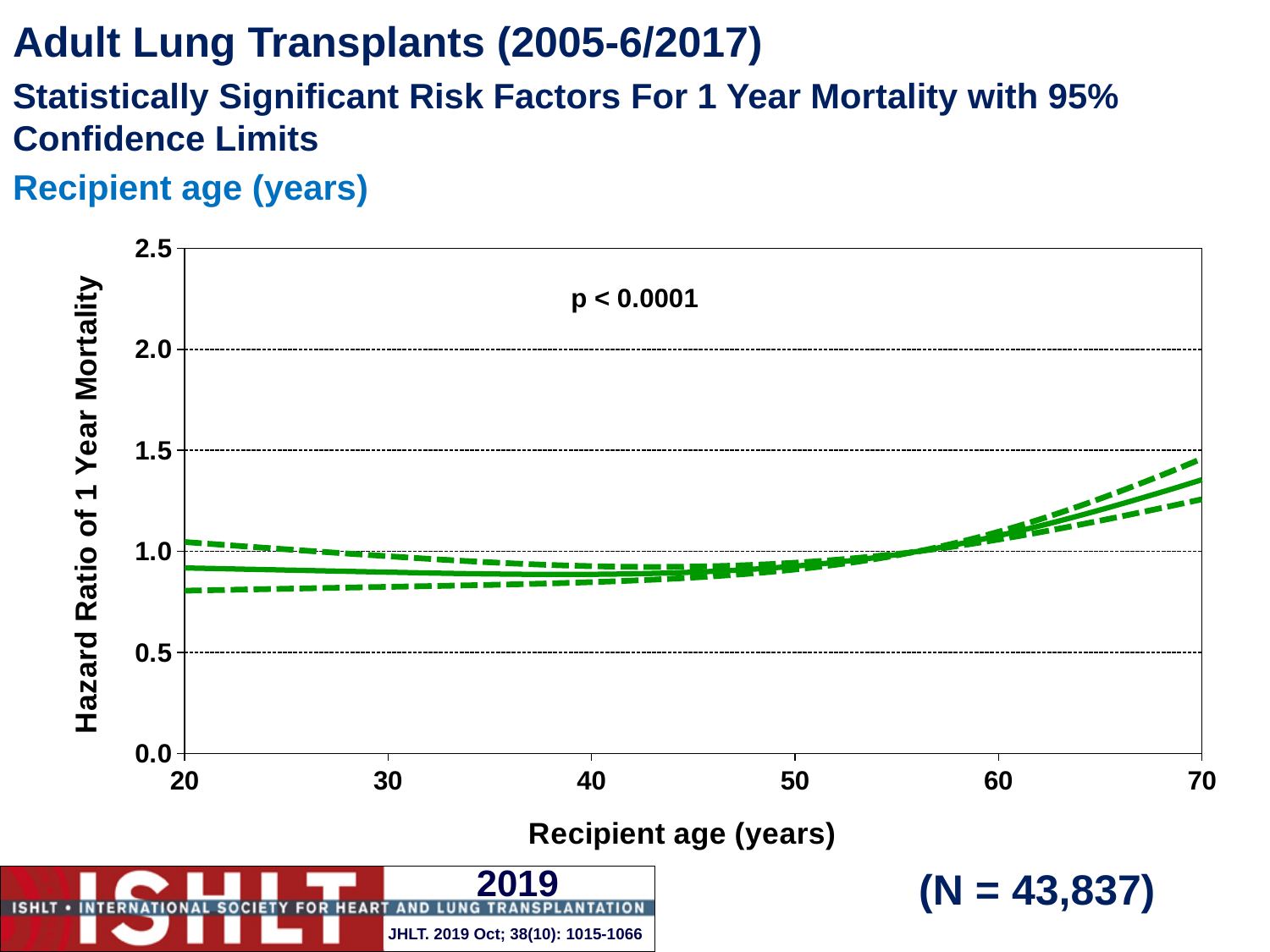
Does the hazard ratio of the solid line rise or fall as recipient age increases from 50 to 70? rise What is the sample size (N) shown on the slide? N = 43,837 How many tick labels are shown on the x axis? 6 What kind of chart is shown on the slide? line chart Is the hazard ratio of the solid line at recipient age 40 greater or less than 1.0? less Is the hazard ratio of the solid line at recipient age 60 greater or less than 1.0? greater How many lines are plotted on the chart? 3 Is the lower dashed confidence limit at recipient age 20 greater or less than 0.5? greater What is the p-value printed on the chart? p < 0.0001